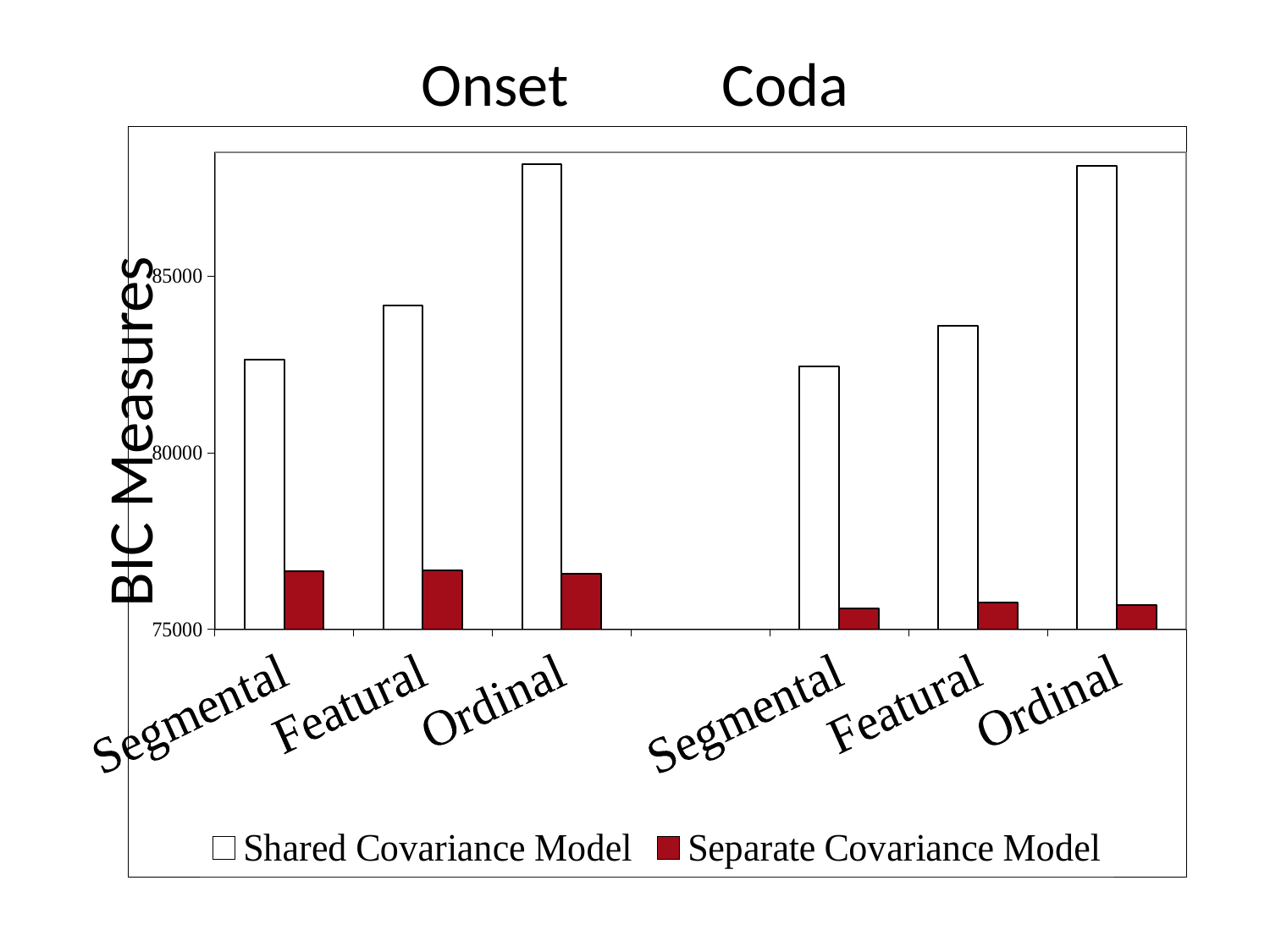
Which series is drawn in dark red? Separate Covariance Model What kind of chart is shown on the slide? bar chart Is the Shared Covariance Model value for Ordinal in the Onset group greater or less than 85000? greater Is the Shared Covariance Model value for Segmental in the Coda group greater or less than 80000? greater Within the Onset group, which category has the highest Shared Covariance Model value? Ordinal Is the Shared Covariance Model value for Segmental in the Onset group greater or less than 85000? less Within the Coda group, which category has the lowest Shared Covariance Model value? Segmental How many series does the legend list? 2 Do the Shared Covariance Model values in the Onset group rise or fall from Segmental to Ordinal? rise How many category labels are shown along the x axis? 6 What is the label on the vertical axis? BIC Measures